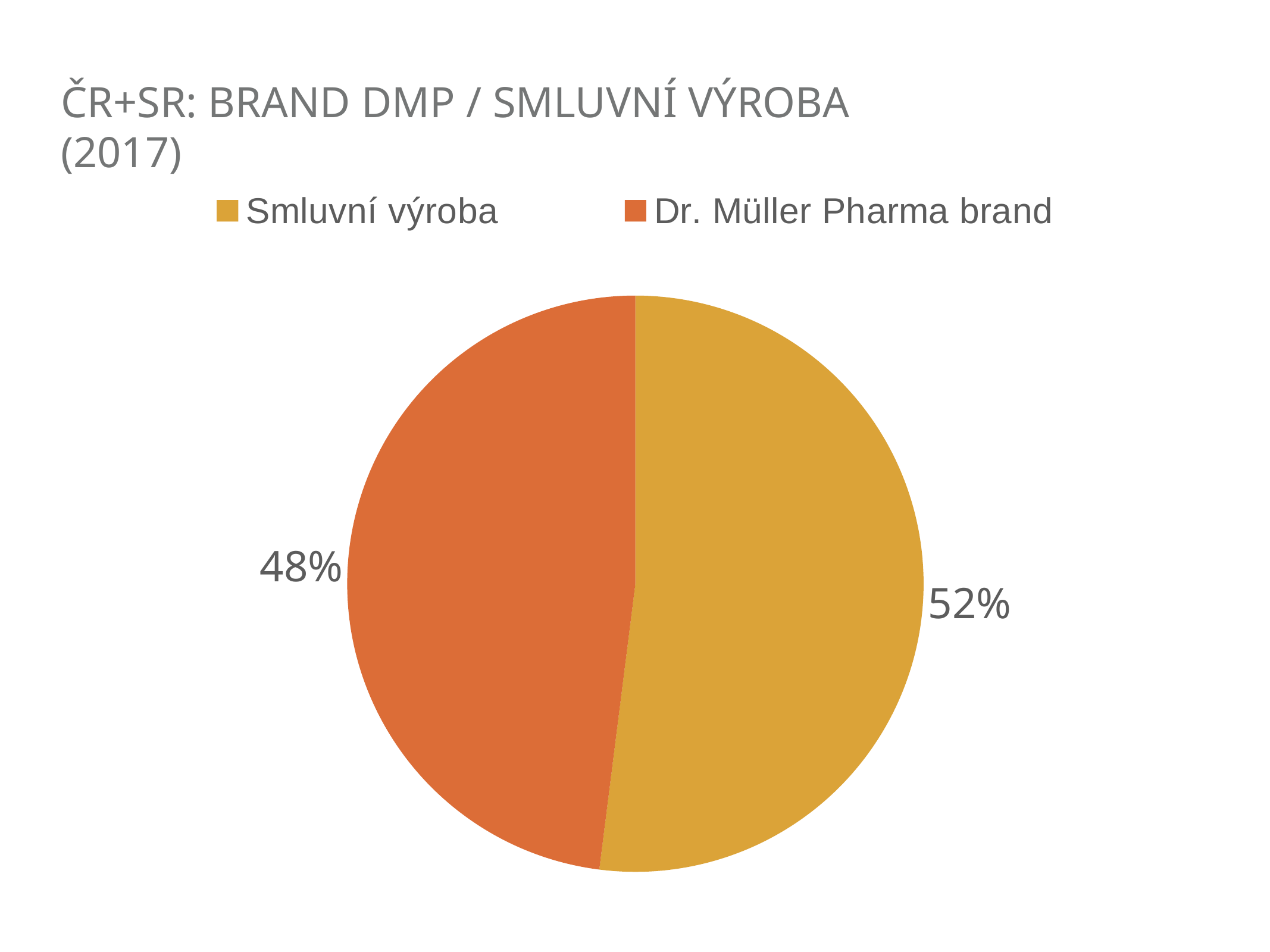
How many slices does the pie chart have? 2 Which slice is the largest? Smluvní výroba What kind of chart is shown on the slide? pie chart What colour is the Dr. Müller Pharma brand slice? orange What is the title of the chart? ČR+SR: BRAND DMP / SMLUVNÍ VÝROBA (2017) What share of the pie does Smluvní výroba have? 52% How many entries does the legend list? 2 Which is larger, Smluvní výroba or Dr. Müller Pharma brand? Smluvní výroba What share of the pie does Dr. Müller Pharma brand have? 48% What is the difference in percentage points between Smluvní výroba and Dr. Müller Pharma brand? 4 Which slice is the smallest? Dr. Müller Pharma brand